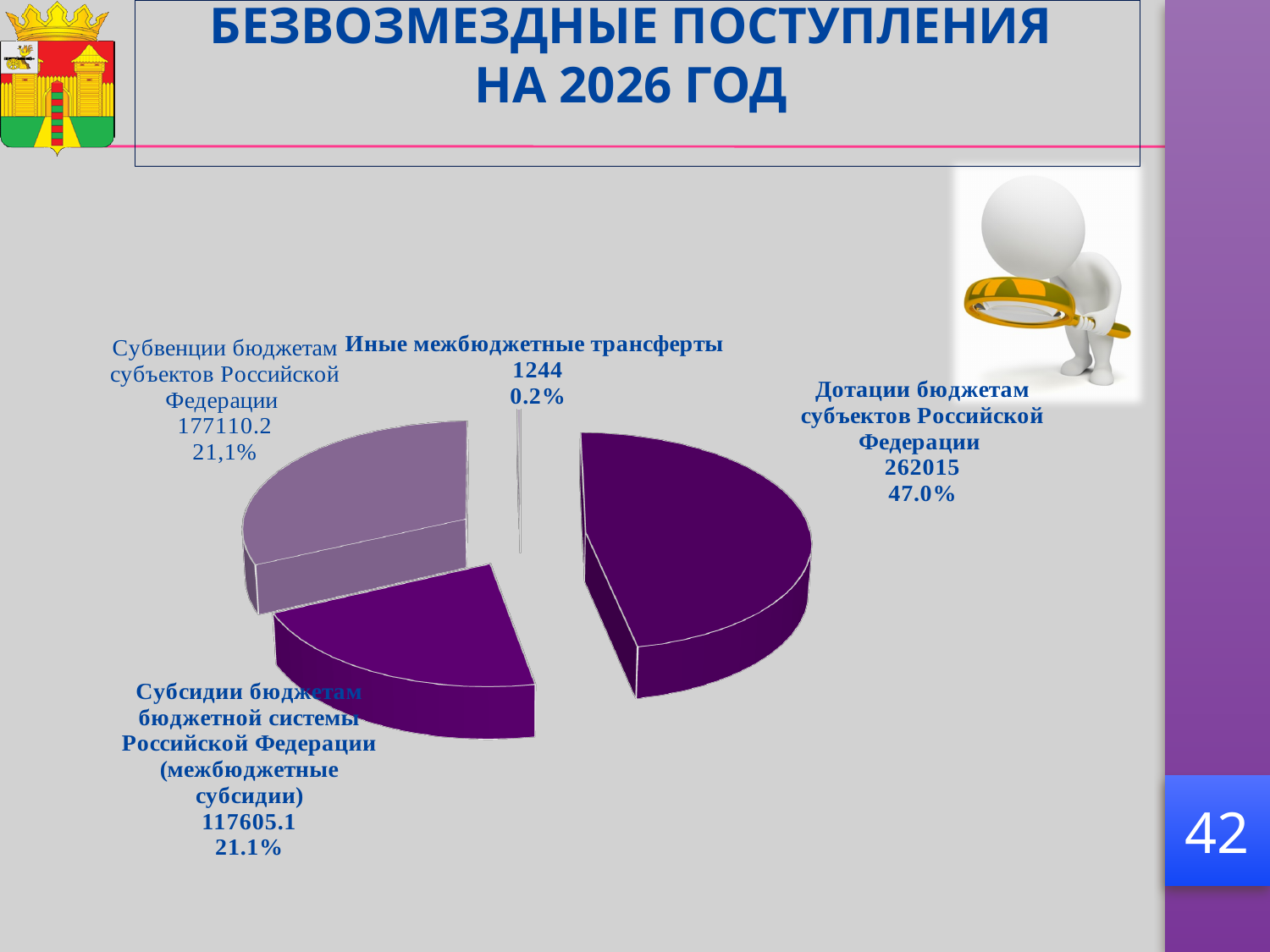
Which category has the smallest slice of the pie? Иные межбюджетные трансферты Which category has the largest slice of the pie? Дотации бюджетам субъектов Российской Федерации What type of chart is shown on the slide? Pie chart What is the difference between the values for Дотации бюджетам субъектов Российской Федерации and Субвенции бюджетам субъектов Российской Федерации? 84904.8 What is the value for Иные межбюджетные трансферты? 1244 What is the value for Субвенции бюджетам субъектов Российской Федерации? 177110.2 What is the value for Субсидии бюджетам бюджетной системы Российской Федерации (межбюджетные субсидии)? 117605.1 What share of the pie does Дотации бюджетам субъектов Российской Федерации represent? 47.0% Which is larger: the value for Субвенции бюджетам субъектов Российской Федерации or the value for Субсидии бюджетам бюджетной системы Российской Федерации (межбюджетные субсидии)? Субвенции бюджетам субъектов Российской Федерации What is the value for Дотации бюджетам субъектов Российской Федерации? 262015 What share of the pie does Иные межбюджетные трансферты represent? 0.2% How many categories does the pie chart show? 4